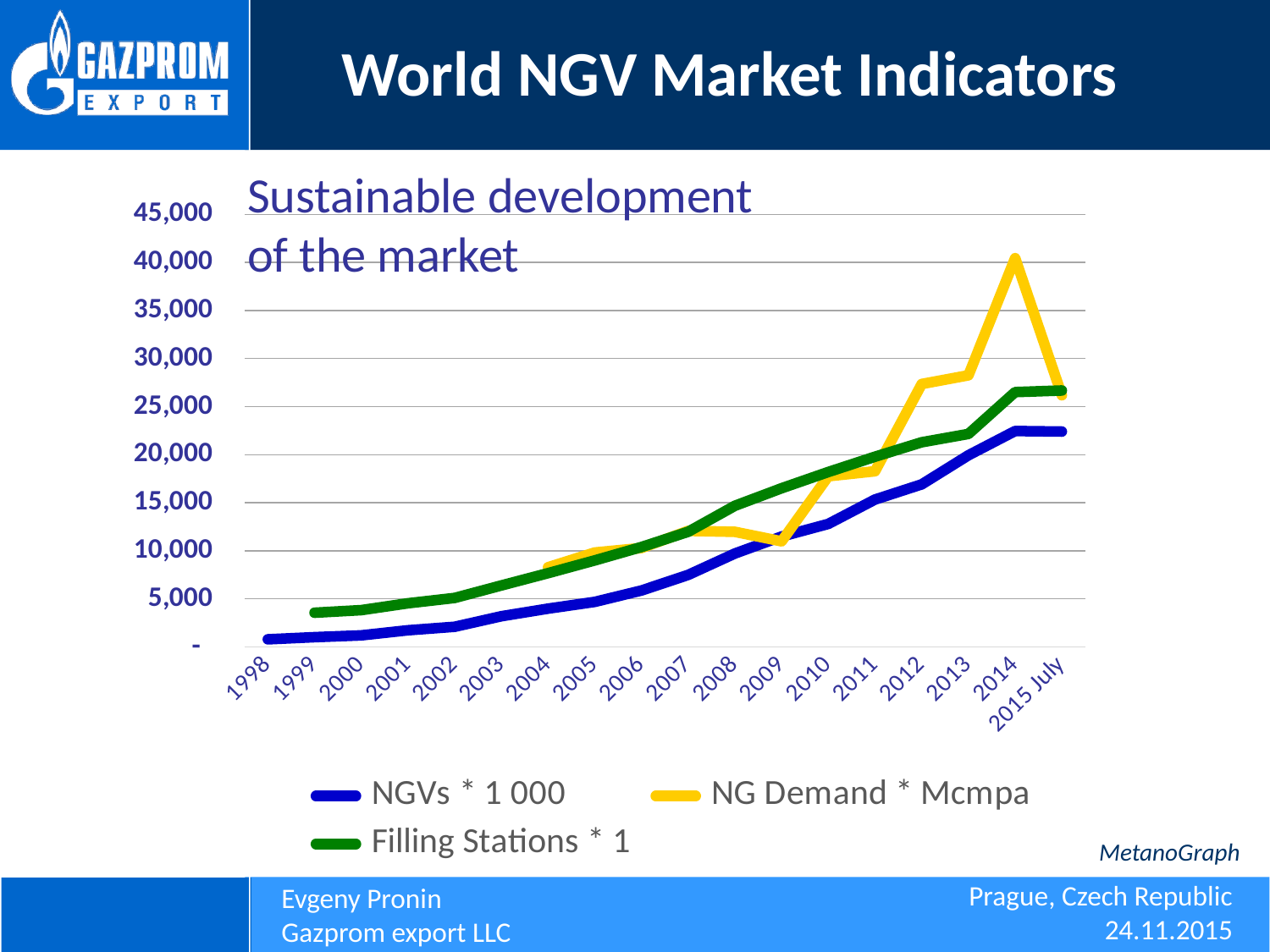
Which series reaches the highest value on the chart? NG Demand * Mcmpa In 2014, which is larger: NG Demand * Mcmpa or NGVs * 1 000? NG Demand * Mcmpa Is the value of NGVs * 1 000 in 2015 July greater or less than 25,000? less In 2015 July, which is larger: Filling Stations * 1 or NGVs * 1 000? Filling Stations * 1 In which year does the NG Demand * Mcmpa series reach its peak? 2014 What is the title of the chart? Sustainable development of the market How many years (categories) are shown along the x axis? 18 Is the value of Filling Stations * 1 in 1999 greater or less than 5,000? less Is the value of NG Demand * Mcmpa in 2014 greater or less than 35,000? greater How many series does the legend list? 3 What kind of chart is shown on the slide? Line chart Does the NGVs * 1 000 series rise or fall from 1998 to 2014? rise